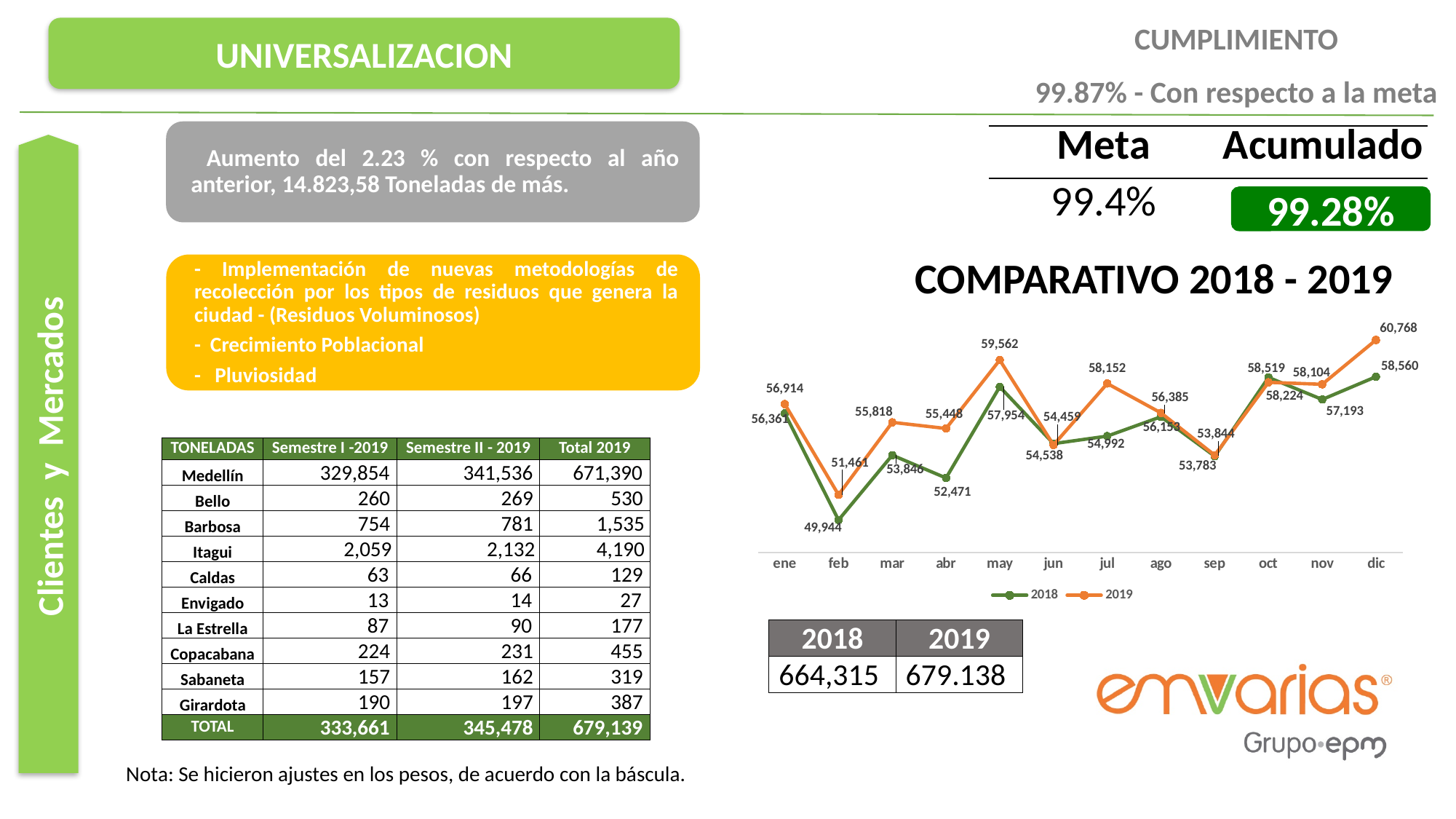
What type of chart is shown under the title COMPARATIVO 2018 - 2019? line chart In the COMPARATIVO 2018 - 2019 chart, what is the difference between the 2019 and 2018 values in dic? 2,208 In the COMPARATIVO 2018 - 2019 chart, which series has the larger value in jul, 2018 or 2019? 2019 In the COMPARATIVO 2018 - 2019 chart, what is the value for 2018 in feb? 49,944 In the COMPARATIVO 2018 - 2019 chart, which month has the highest value for the 2019 series? dic In the COMPARATIVO 2018 - 2019 chart, what is the value for 2019 in may? 59,562 In the COMPARATIVO 2018 - 2019 chart, which month has the lowest value for the 2018 series? feb In the COMPARATIVO 2018 - 2019 chart, what is the value for 2018 in dic? 58,560 In the COMPARATIVO 2018 - 2019 chart, what is the difference between the 2019 and 2018 values in feb? 1,517 How many series does the legend of the COMPARATIVO 2018 - 2019 chart list? 2 In the COMPARATIVO 2018 - 2019 chart, does the 2019 series rise or fall from ene to feb? fall How many months are plotted along the x axis of the COMPARATIVO 2018 - 2019 chart? 12